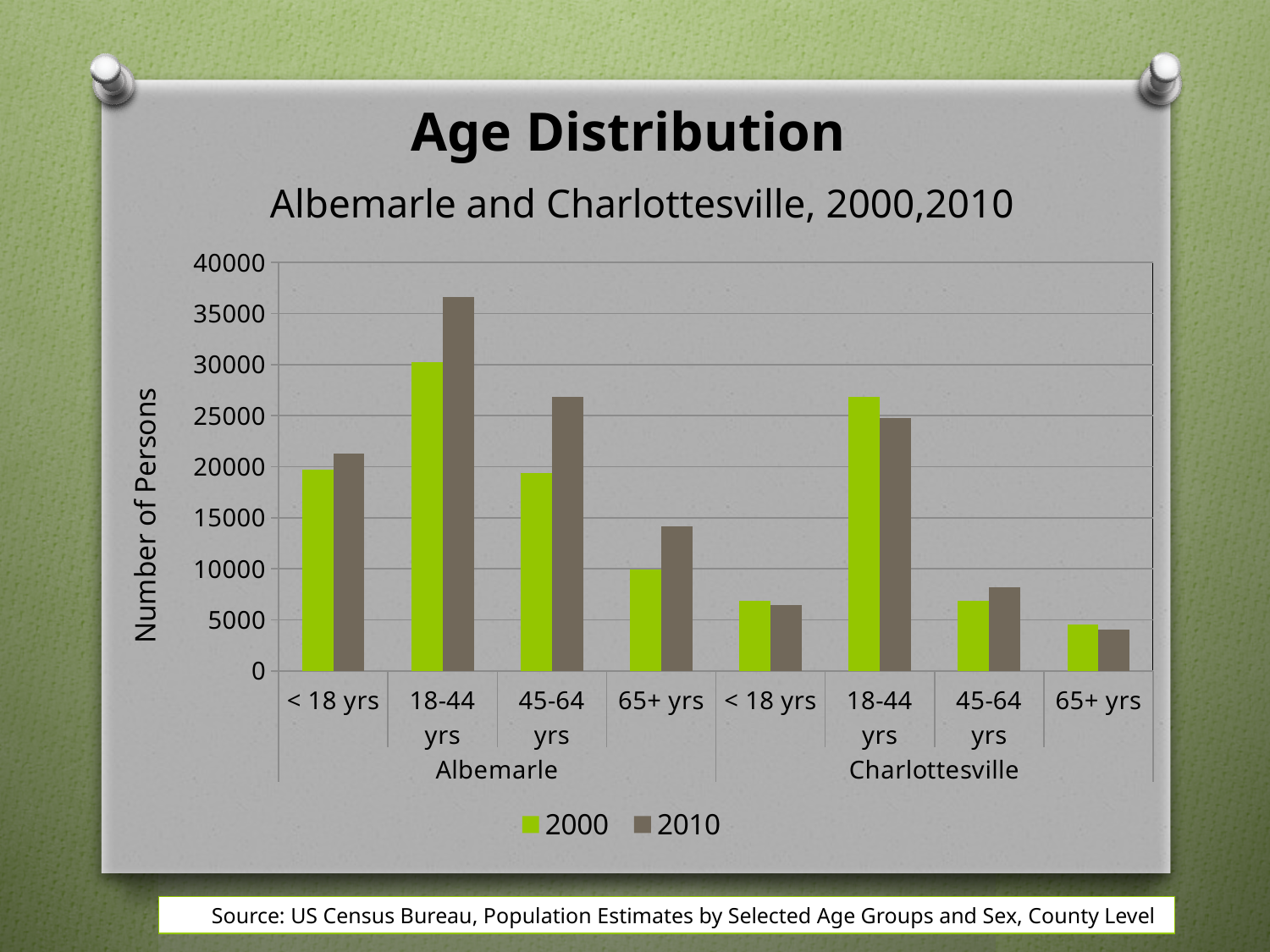
Which bar is the shortest in the chart? Charlottesville 65+ yrs, 2010 Which colour represents the 2000 series in the legend? green What kind of chart is shown on the slide? bar chart What is the title of the vertical axis? Number of Persons Is the 2010 value for Albemarle 18-44 yrs greater or less than 35000? greater Which bar is the tallest in the chart? Albemarle 18-44 yrs, 2010 Is the 2000 value for Charlottesville < 18 yrs greater or less than 10000? less How many age-group categories are shown along the x axis in total? 8 How many series does the legend list? 2 Is the 2010 value for Albemarle 65+ yrs greater or less than 15000? less For Albemarle 45-64 yrs, which year has the larger value, 2000 or 2010? 2010 For Charlottesville 18-44 yrs, which year has the larger value, 2000 or 2010? 2000